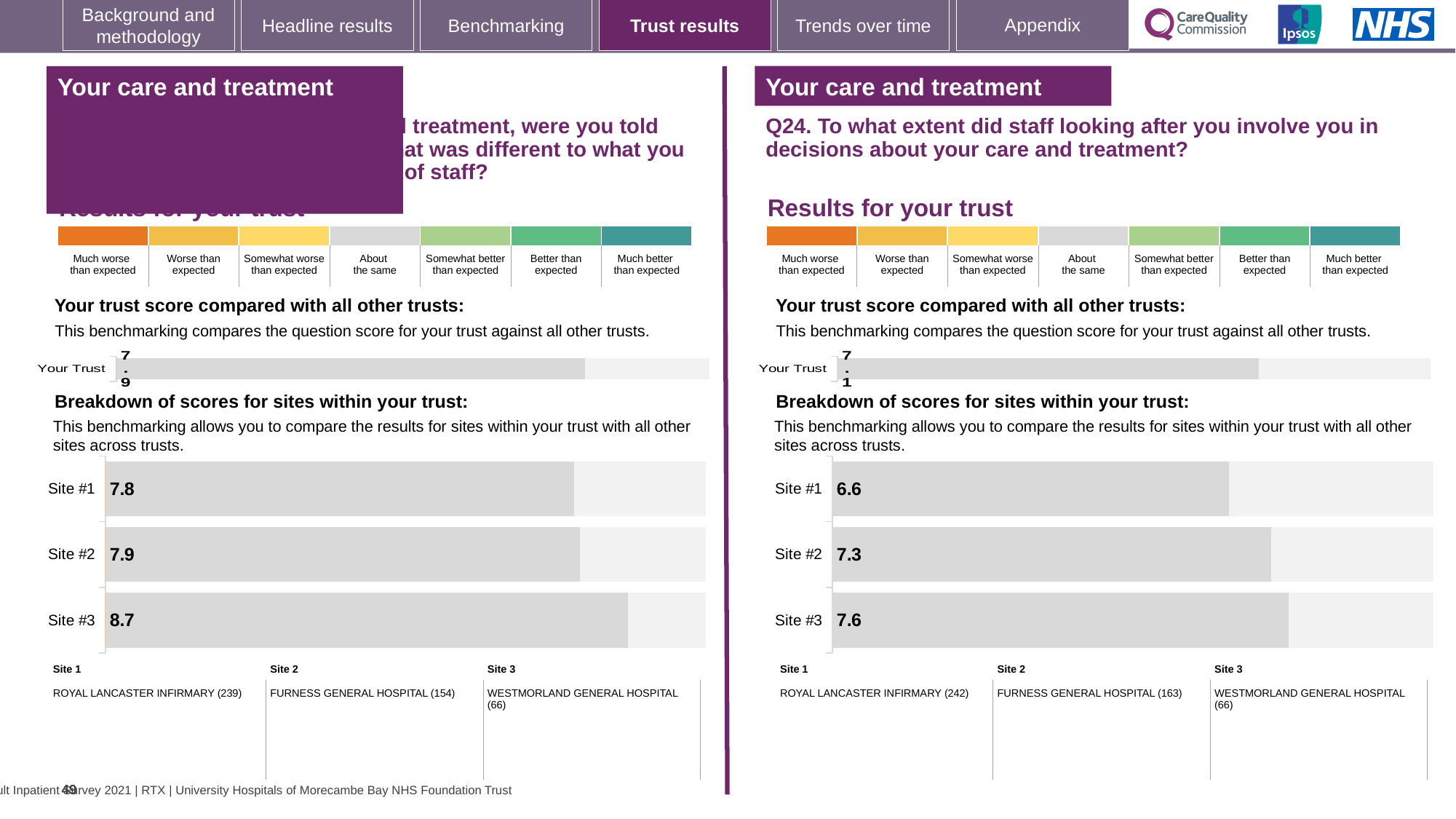
On the right-hand (Q24) site breakdown chart, what is the score for Site #2? 7.3 On the right-hand (Q24) site breakdown chart, which has the larger score, Site #2 or Site #3? Site #3 On the right-hand (Q24) site breakdown chart, what is the difference between the scores for Site #3 and Site #1? 1.0 On the right-hand (Q24) site breakdown chart, which site has the lowest score? Site #1 On the right-hand (Q24) 'Your Trust' chart, what is the trust score shown? 7.1 What type of chart is used for the site breakdown on the right-hand (Q24) side of the slide? Bar chart On the left-hand site breakdown chart, what is the score for Site #1? 7.8 On the left-hand site breakdown chart, what is the difference between the scores for Site #3 and Site #1? 0.9 On the right-hand (Q24) site breakdown chart, what is the score for Site #1? 6.6 How many sites are shown on the left-hand site breakdown chart? 3 On the left-hand site breakdown chart, what is the score for Site #3? 8.7 On the left-hand site breakdown chart, which site has the highest score? Site #3